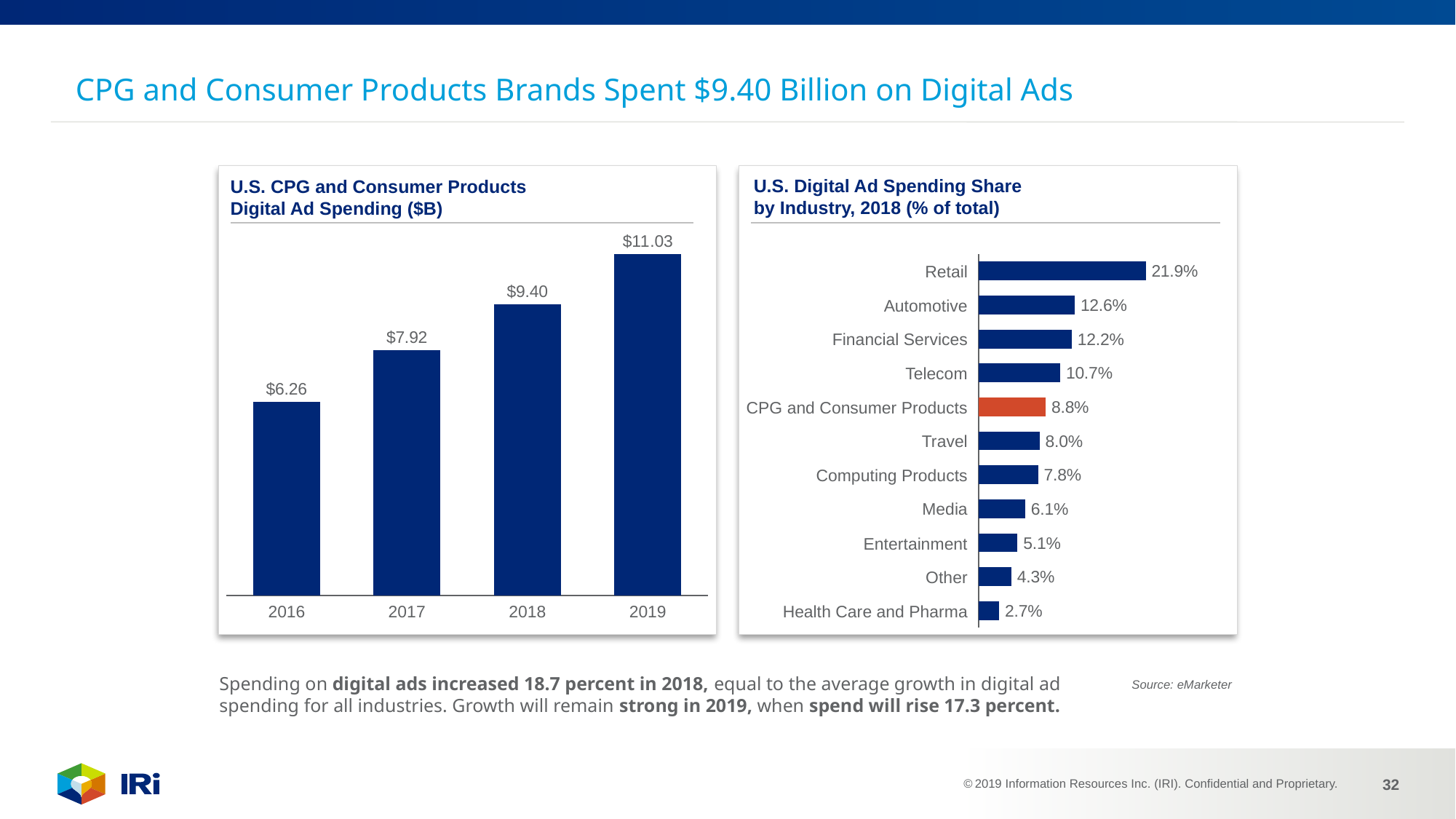
In the 'U.S. CPG and Consumer Products Digital Ad Spending ($B)' chart, which year has the lowest value? 2016 In the 'U.S. Digital Ad Spending Share by Industry, 2018' chart, which bar is coloured orange rather than blue? CPG and Consumer Products In the 'U.S. Digital Ad Spending Share by Industry, 2018' chart, what is the difference between Retail and CPG and Consumer Products? 13.1% In the 'U.S. Digital Ad Spending Share by Industry, 2018' chart, which is larger: Automotive or Financial Services? Automotive In the 'U.S. CPG and Consumer Products Digital Ad Spending ($B)' chart, what is the difference between the 2019 and 2016 values? $4.77 What kind of chart is the 'U.S. CPG and Consumer Products Digital Ad Spending ($B)' chart? bar chart How many years are shown in the 'U.S. CPG and Consumer Products Digital Ad Spending ($B)' chart? 4 In the 'U.S. CPG and Consumer Products Digital Ad Spending ($B)' chart, do the values rise or fall from 2016 to 2019? rise In the 'U.S. Digital Ad Spending Share by Industry, 2018' chart, which industry has the highest share? Retail In the 'U.S. Digital Ad Spending Share by Industry, 2018' chart, which industry has the lowest share? Health Care and Pharma In the 'U.S. CPG and Consumer Products Digital Ad Spending ($B)' chart, what is the value for 2018? $9.40 In the 'U.S. Digital Ad Spending Share by Industry, 2018' chart, what is the value for Telecom? 10.7%